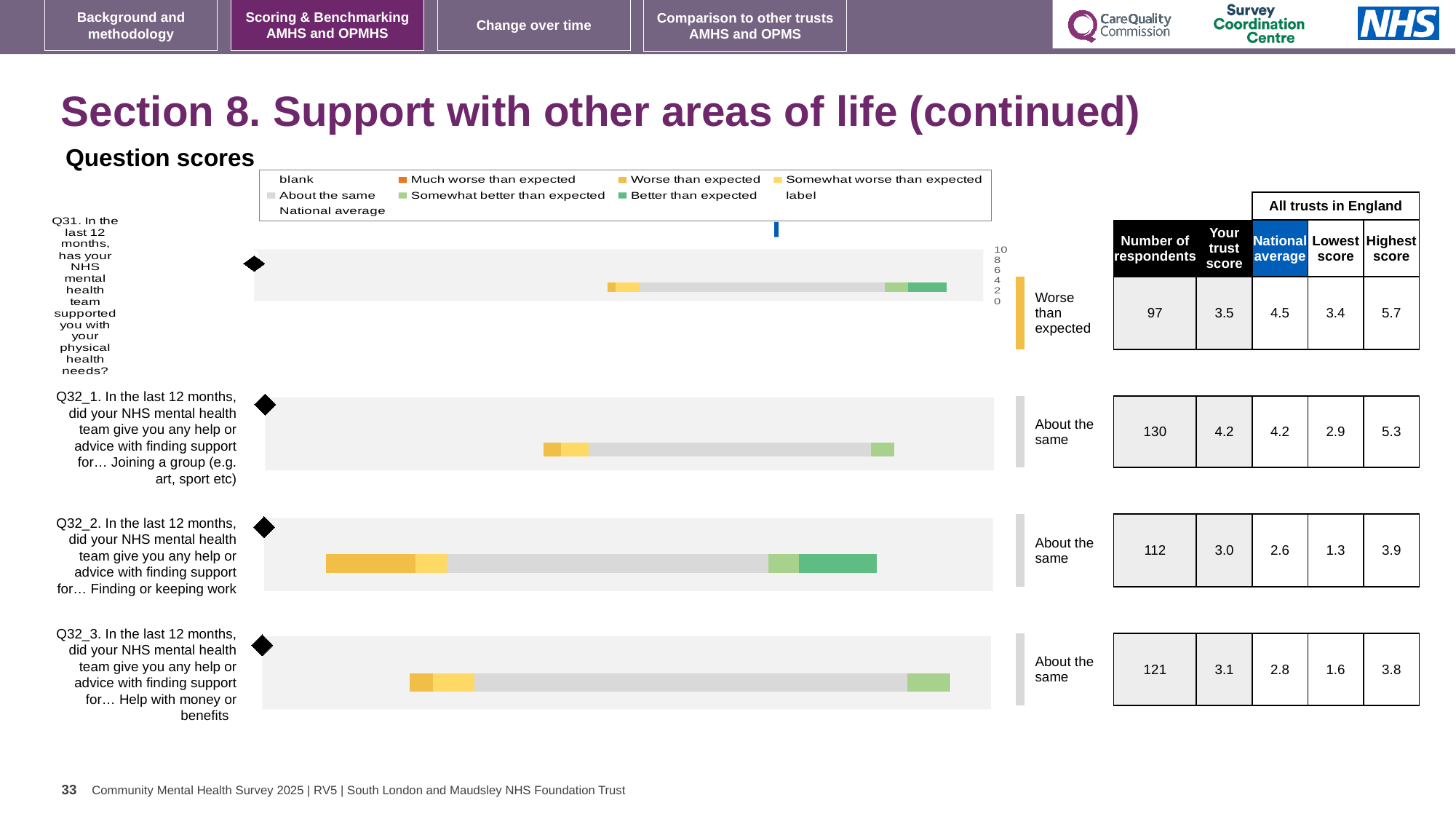
Which question has the highest number of respondents? Q32_1 (Joining a group) For Q31, which is larger: the trust score or the national average? National average For Q32_2, what is the difference between the highest score and the lowest score across all trusts in England? 2.6 What is the lowest score across all trusts in England for Q32_1 (joining a group)? 2.9 What colour represents 'Better than expected' in the legend? Green How many entries does the legend of the question scores chart list? 9 Which benchmark category is Q31 assigned to? Worse than expected What is the national average for Q32_3 (help with money or benefits)? 2.8 How many respondents are shown for Q32_2 (finding or keeping work)? 112 How many questions (bars) are plotted in the question scores chart? 4 What is the 'Your trust score' value for Q31 (support with physical health needs)? 3.5 What kind of chart is used to show the question scores on this slide? Bar chart